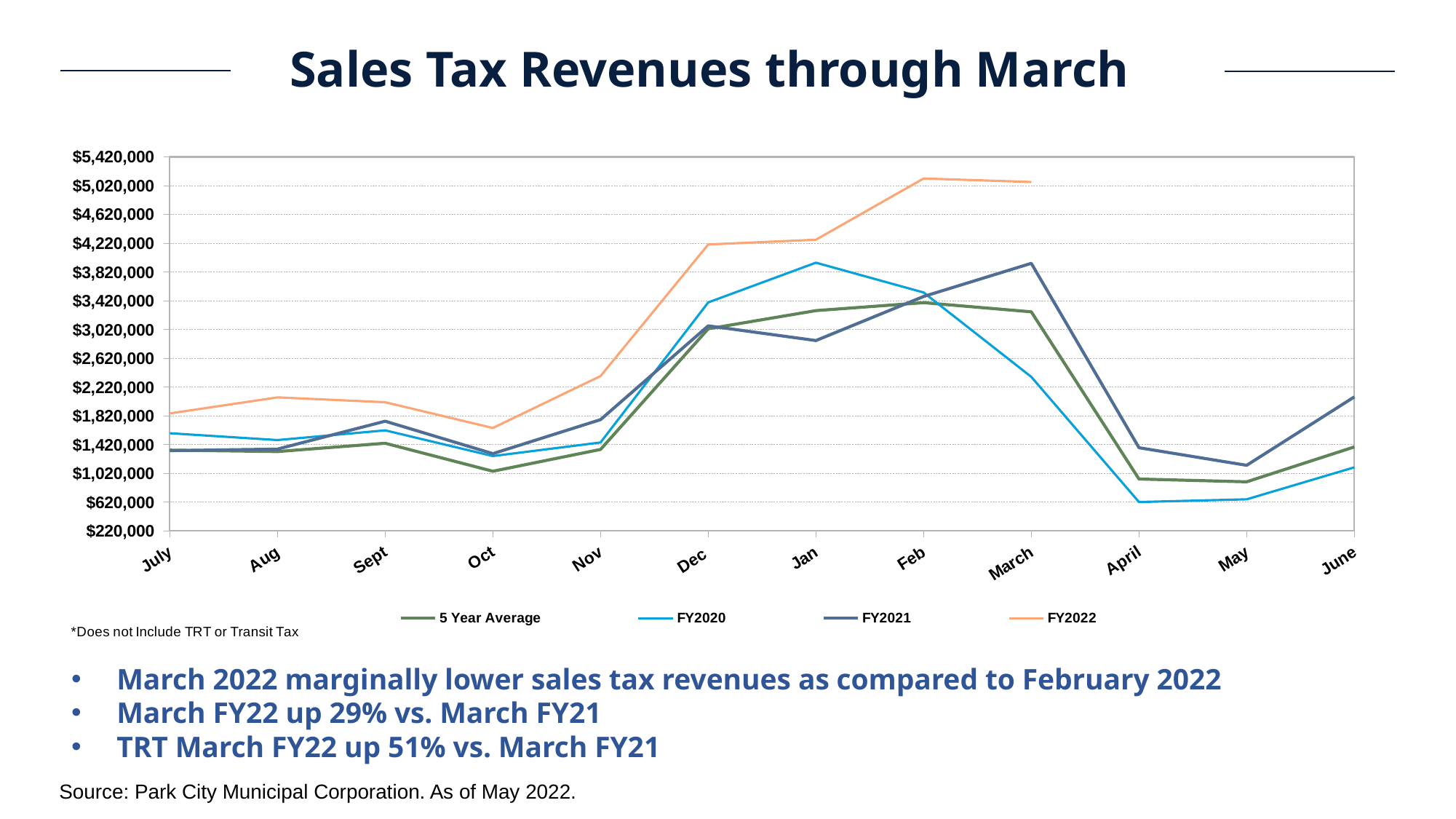
In Jan, which is larger: the FY2020 value or the FY2021 value? FY2020 In which month does the FY2020 line reach its highest value? Jan What kind of chart is shown on the slide? line chart How many series does the legend list? 4 In Dec, which is larger: the FY2022 value or the FY2020 value? FY2022 In which month does the FY2021 line reach its lowest value? May Does the FY2022 line rise or fall from Oct to Feb? rise What colour is the FY2022 line in the legend? orange Is the FY2021 value for March greater or less than $3,820,000? greater How many months are shown along the x axis? 12 Is the FY2020 value for April greater or less than $1,020,000? less Is the FY2022 value for Feb greater or less than $5,020,000? greater